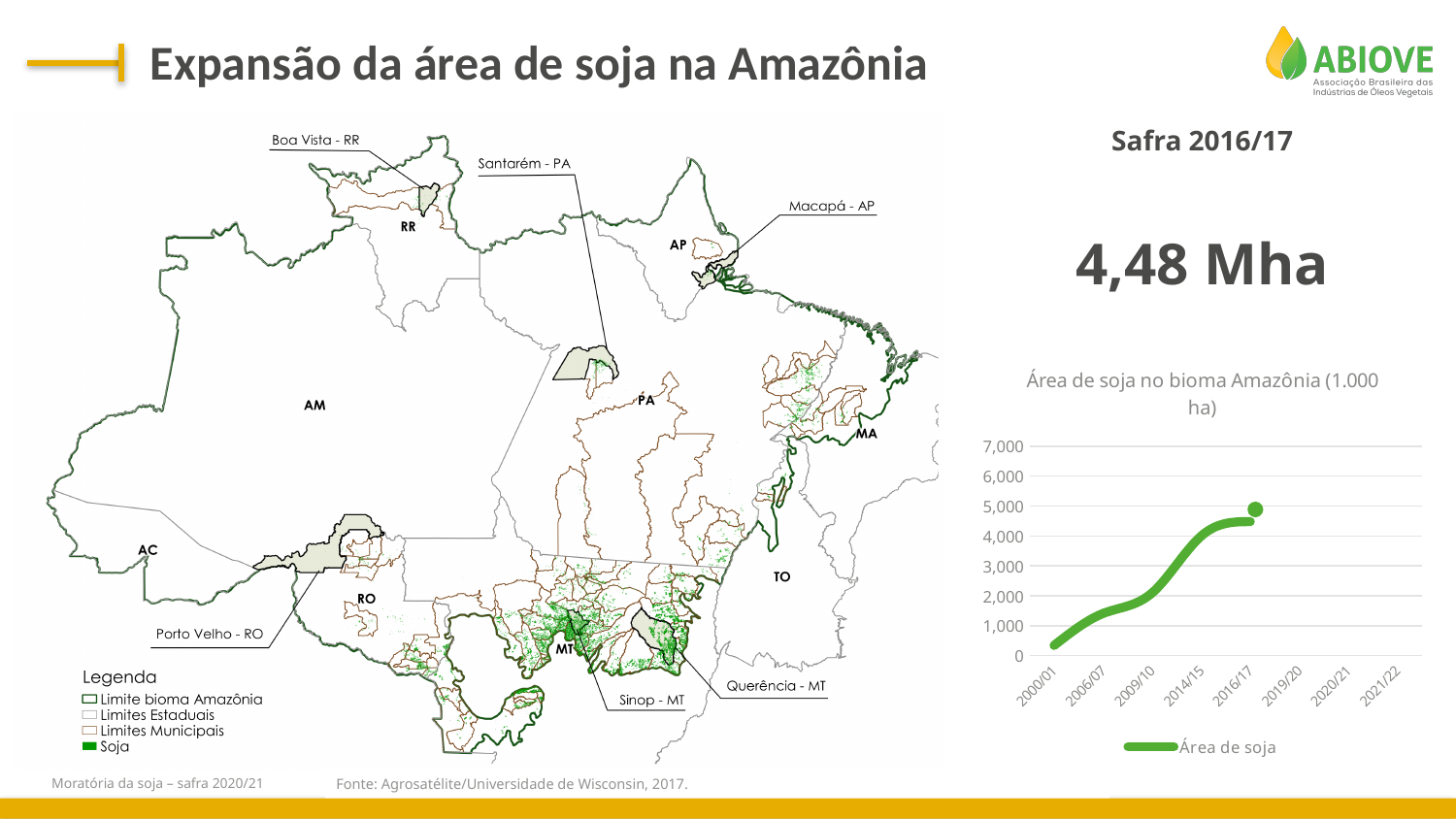
Is the value for 2016/17 greater or less than 4,000? greater What kind of chart is shown on the right side of the slide? line chart How many series does the legend of the chart list? 1 Is the value for 2014/15 greater or less than 3,000? greater Is the value for 2000/01 greater or less than 1,000? less Do the values in the chart rise or fall from 2000/01 to 2016/17? rise How many category labels are shown on the x axis of the chart? 8 Which season has the lowest plotted value in the chart? 2000/01 What is the title of the chart on the right side of the slide? Área de soja no bioma Amazônia (1.000 ha) What is the name of the series shown in the chart legend? Área de soja Which season has the highest plotted value in the chart? 2016/17 Which is larger, the value for 2016/17 or the value for 2000/01? 2016/17